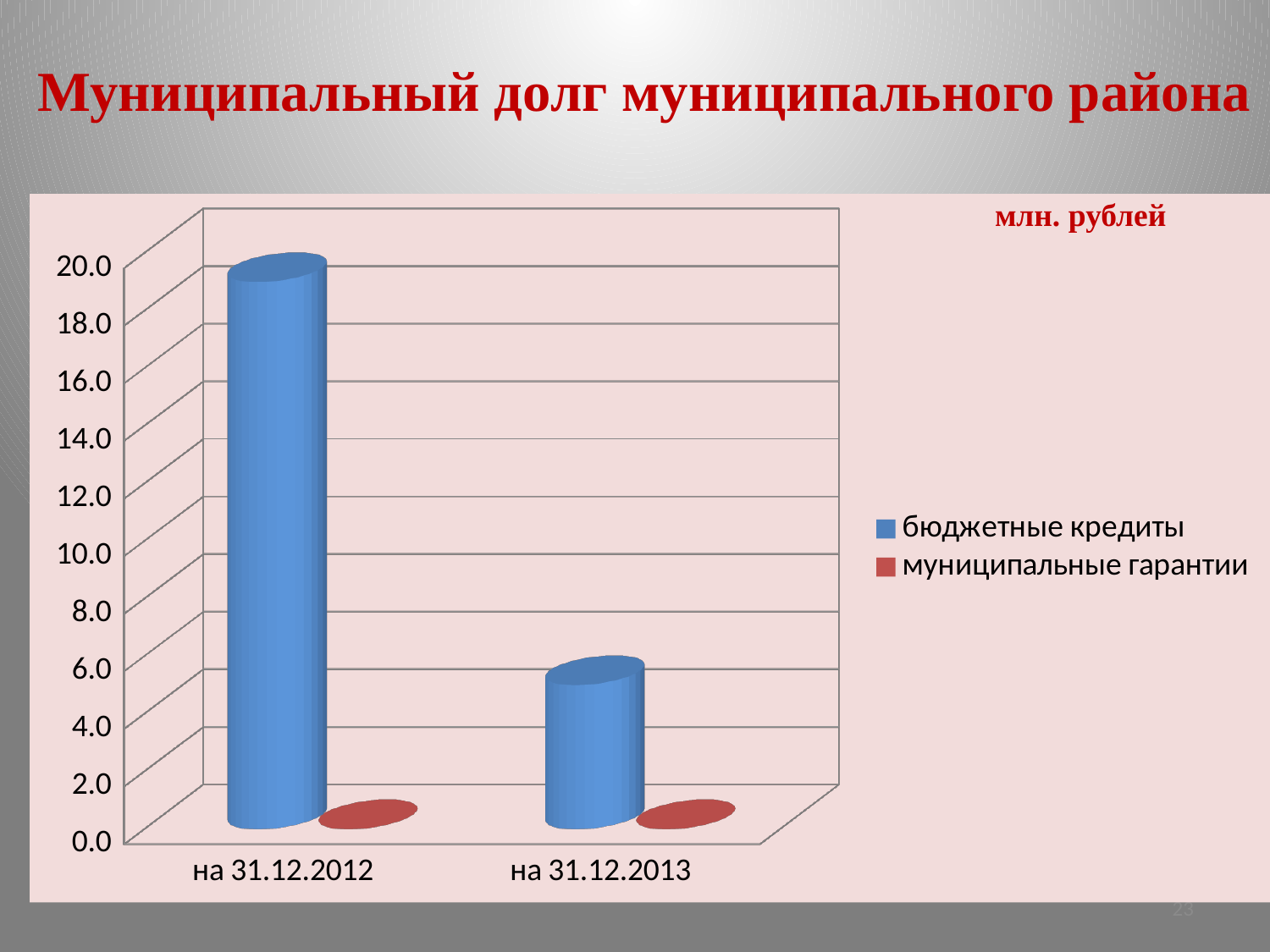
In what units are the values on the chart expressed? млн. рублей What is the title of the slide? Муниципальный долг муниципального района How many series does the legend list? 2 What kind of chart is shown on the slide? bar chart How many categories are shown on the x axis? 2 Is the value for бюджетные кредиты на 31.12.2012 greater or less than 16.0? greater Do the values for бюджетные кредиты rise or fall from 31.12.2012 to 31.12.2013? fall Which category has the highest value for бюджетные кредиты? на 31.12.2012 Is the value for бюджетные кредиты на 31.12.2013 greater or less than 8.0? less Which category has the lowest value for бюджетные кредиты? на 31.12.2013 Which is larger, бюджетные кредиты на 31.12.2012 or бюджетные кредиты на 31.12.2013? на 31.12.2012 What is the value for муниципальные гарантии на 31.12.2013? 0.0